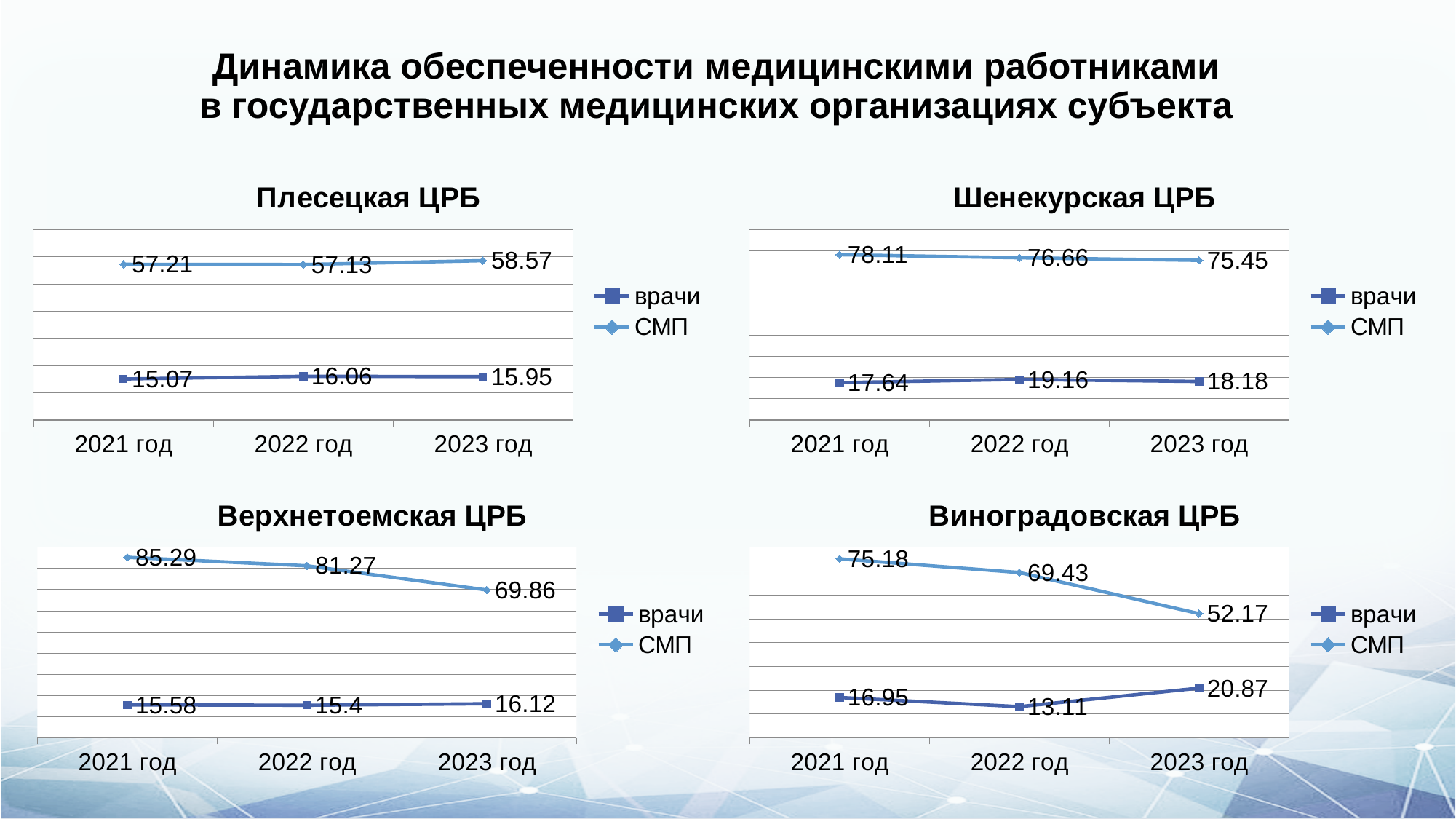
In the Шенекурская ЦРБ chart, what is the difference between the СМП and врачи values in 2021 год? 60.47 In the Плесецкая ЦРБ chart, what is the value for СМП in 2023 год? 58.57 In the Виноградовская ЦРБ chart, what is the value for СМП in 2021 год? 75.18 In the Шенекурская ЦРБ chart, what is the value for врачи in 2022 год? 19.16 What kind of chart is the Плесецкая ЦРБ chart? line chart In the Плесецкая ЦРБ chart, which is larger: the врачи value in 2022 год or in 2021 год? 2022 год In the Верхнетоемская ЦРБ chart, what is the difference between the СМП values for 2021 год and 2023 год? 15.43 How many series does the legend of the Шенекурская ЦРБ chart list? 2 How many years are shown on the x axis of the Верхнетоемская ЦРБ chart? 3 In the Виноградовская ЦРБ chart, in which year is the врачи value highest? 2023 год In the Верхнетоемская ЦРБ chart, in which year is the СМП value lowest? 2023 год In the Виноградовская ЦРБ chart, does the СМП value rise or fall from 2021 год to 2023 год? fall